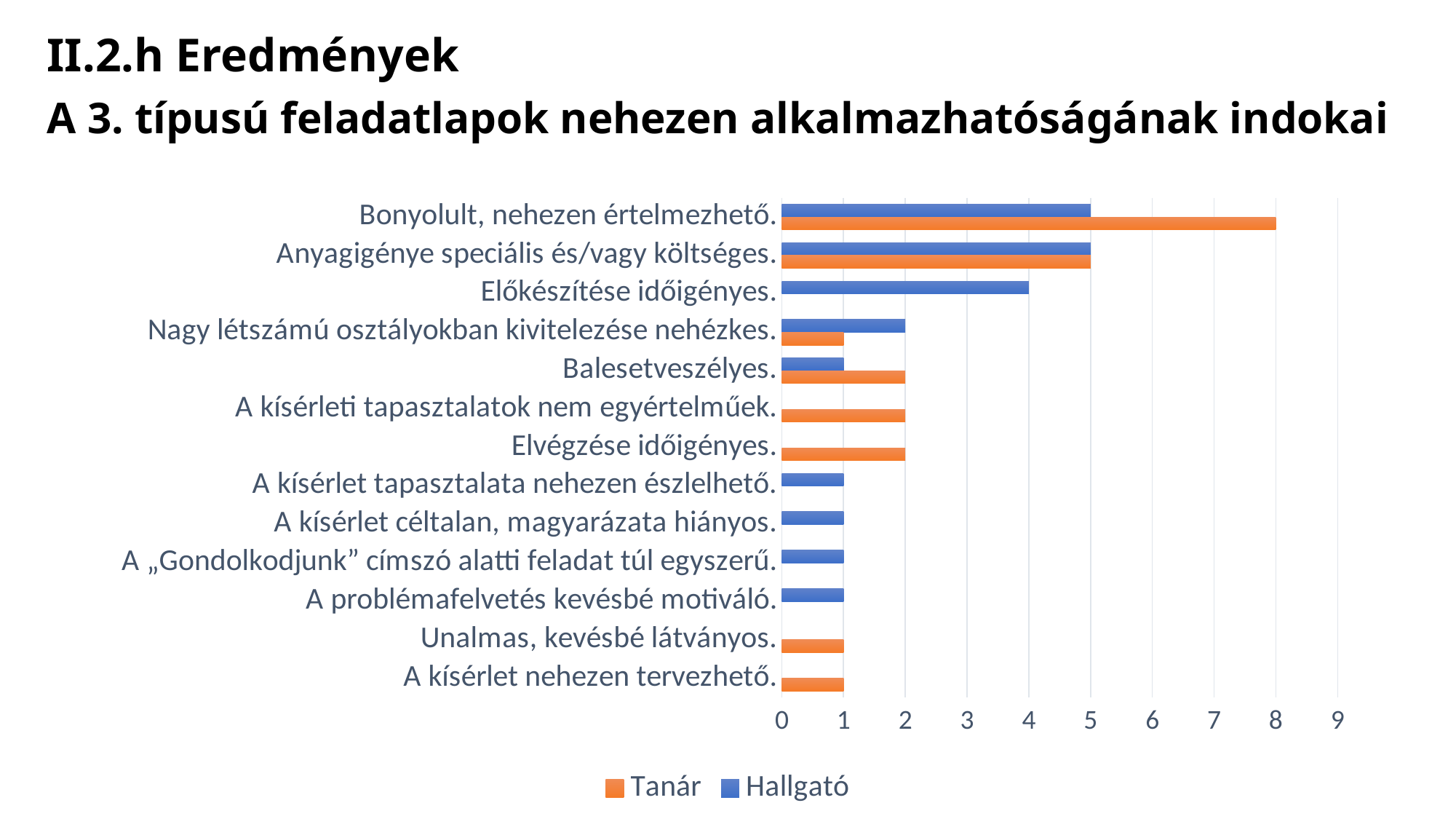
What is the difference between the Tanár and Hallgató values for "Bonyolult, nehezen értelmezhető."? 3 What is the Hallgató value for "Előkészítése időigényes."? 4 What is the Tanár value for "Anyagigénye speciális és/vagy költséges."? 5 What is the Tanár value for "Elvégzése időigényes."? 2 What is the Tanár value for "Bonyolult, nehezen értelmezhető."? 8 Which category has the highest Tanár value? Bonyolult, nehezen értelmezhető. For "Balesetveszélyes.", which series has the larger value, Tanár or Hallgató? Tanár What is the Hallgató value for "Nagy létszámú osztályokban kivitelezése nehézkes."? 2 Which colour represents the Hallgató series? blue How many series does the legend list? 2 How many categories are shown on the chart? 13 What kind of chart is shown on the slide? bar chart